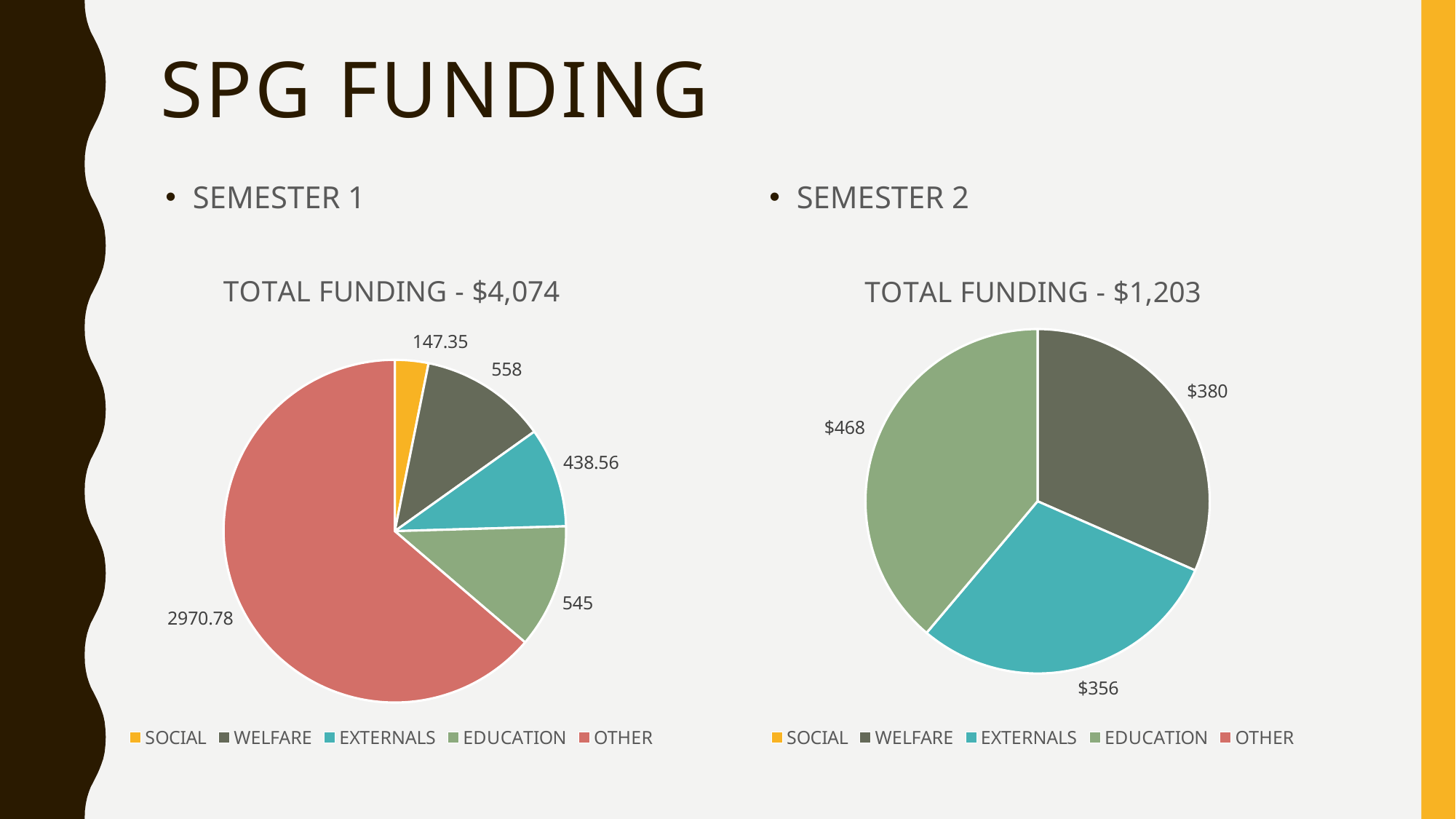
In the Semester 1 chart, which category has the smallest slice? Social In the Semester 1 chart, which category has the largest slice? Other In the Semester 2 chart, what is the difference between the Education and Externals values? $112 In the Semester 1 chart (Total Funding - $4,074), what is the value for Other? 2970.78 What type of chart is used for Semester 1? Pie chart In the Semester 2 chart, which category has the largest slice? Education In the Semester 2 chart (Total Funding - $1,203), what is the value for Education? $468 In the Semester 1 chart, which is larger, Externals or Education? Education In the Semester 2 chart, what is the value for Externals? $356 In the Semester 1 chart, what is the value for Social? 147.35 In the Semester 1 chart, what is the difference between the Welfare and Education values? 13 How many slices are visible in the Semester 2 pie chart? 3